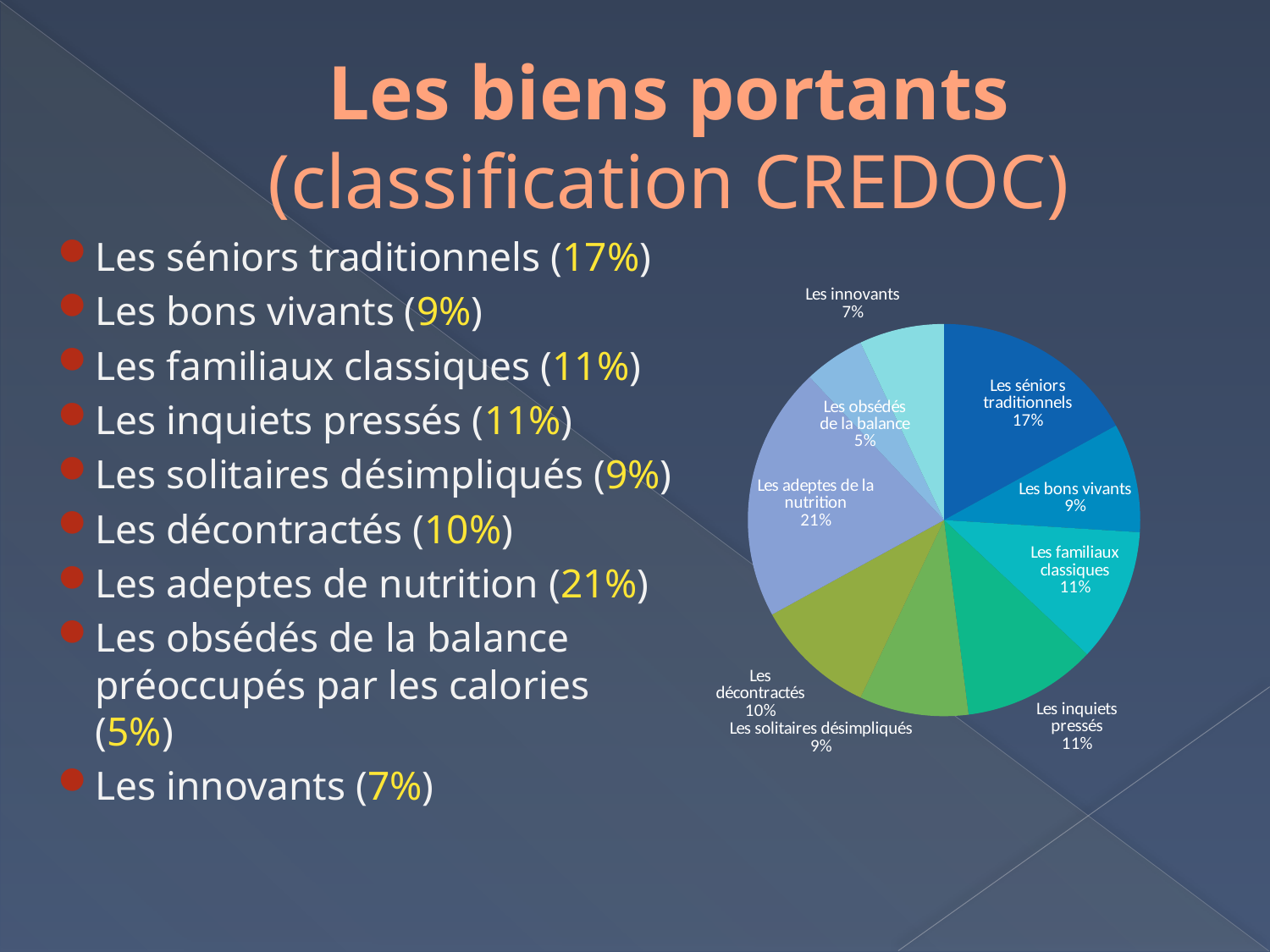
What percentage does the pie chart show for Les obsédés de la balance? 5% What is the difference in percentage points between Les décontractés and Les obsédés de la balance? 5 What percentage does the pie chart show for Les innovants? 7% Which category has the largest slice in the pie chart? Les adeptes de la nutrition What kind of chart is shown on the slide? pie chart What percentage does the pie chart show for Les adeptes de la nutrition? 21% What percentage does the pie chart show for Les familiaux classiques? 11% Which category has the smallest slice in the pie chart? Les obsédés de la balance What is the difference in percentage points between Les adeptes de la nutrition and Les séniors traditionnels? 4 What percentage does the pie chart show for Les séniors traditionnels? 17% How many slices does the pie chart have? 9 Which is larger in the pie chart: Les décontractés or Les innovants? Les décontractés